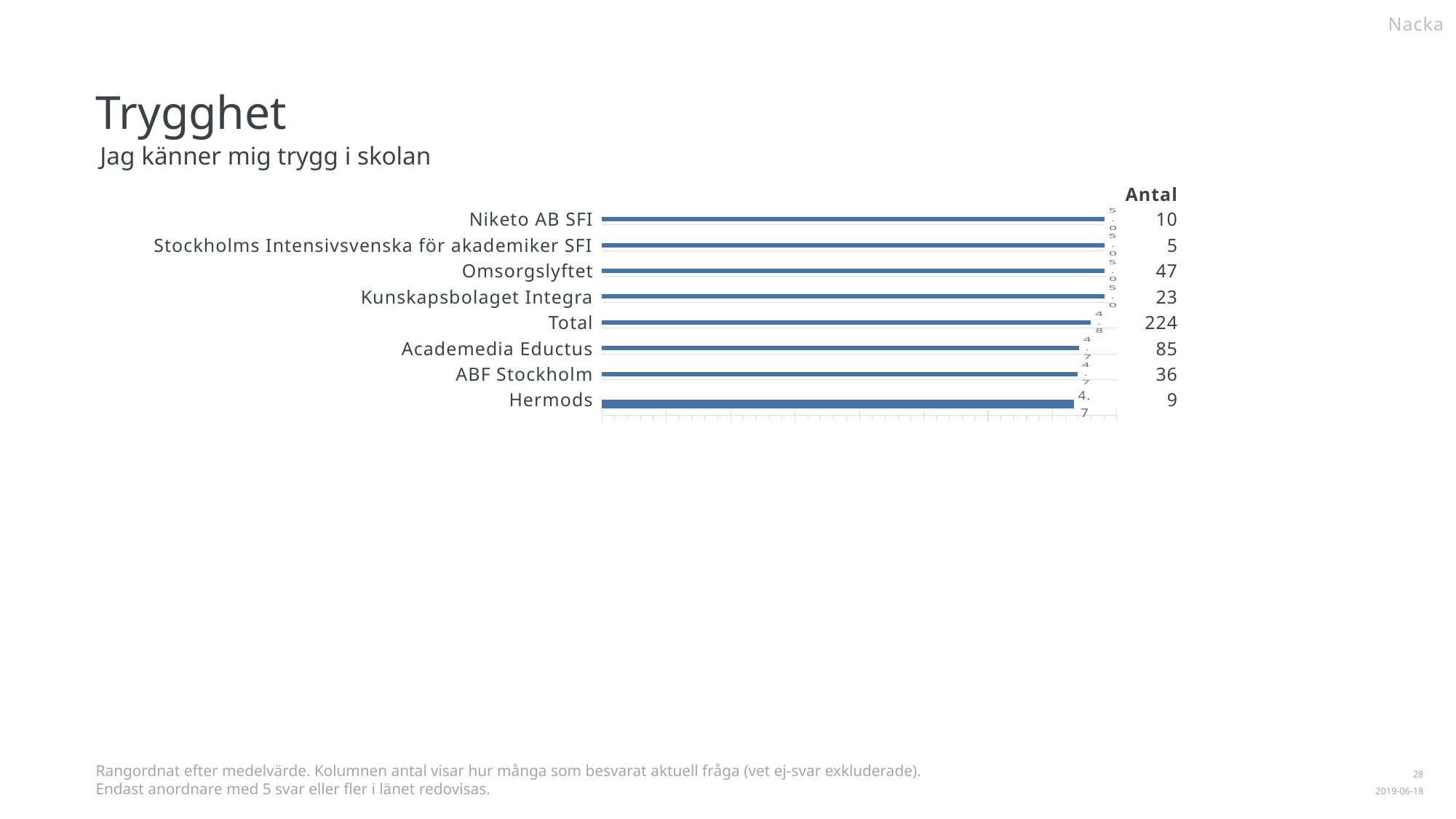
What is the value shown for Niketo AB SFI? 5.0 What statement is the chart about, as given in the subtitle? Jag känner mig trygg i skolan What kind of chart is shown on the slide? bar chart What is the Antal for Omsorgslyftet? 47 Which row has the lowest Antal? Stockholms Intensivsvenska för akademiker SFI What is the heading of the numeric column to the right of the bars? Antal How many providers (categories) are listed in the chart? 8 Which has the larger value, Niketo AB SFI or Hermods? Niketo AB SFI What is the Antal (number of respondents) for Total? 224 What is the difference in Antal between Academedia Eductus and ABF Stockholm? 49 What is the Antal for Academedia Eductus? 85 What is the value shown for Hermods? 4.7